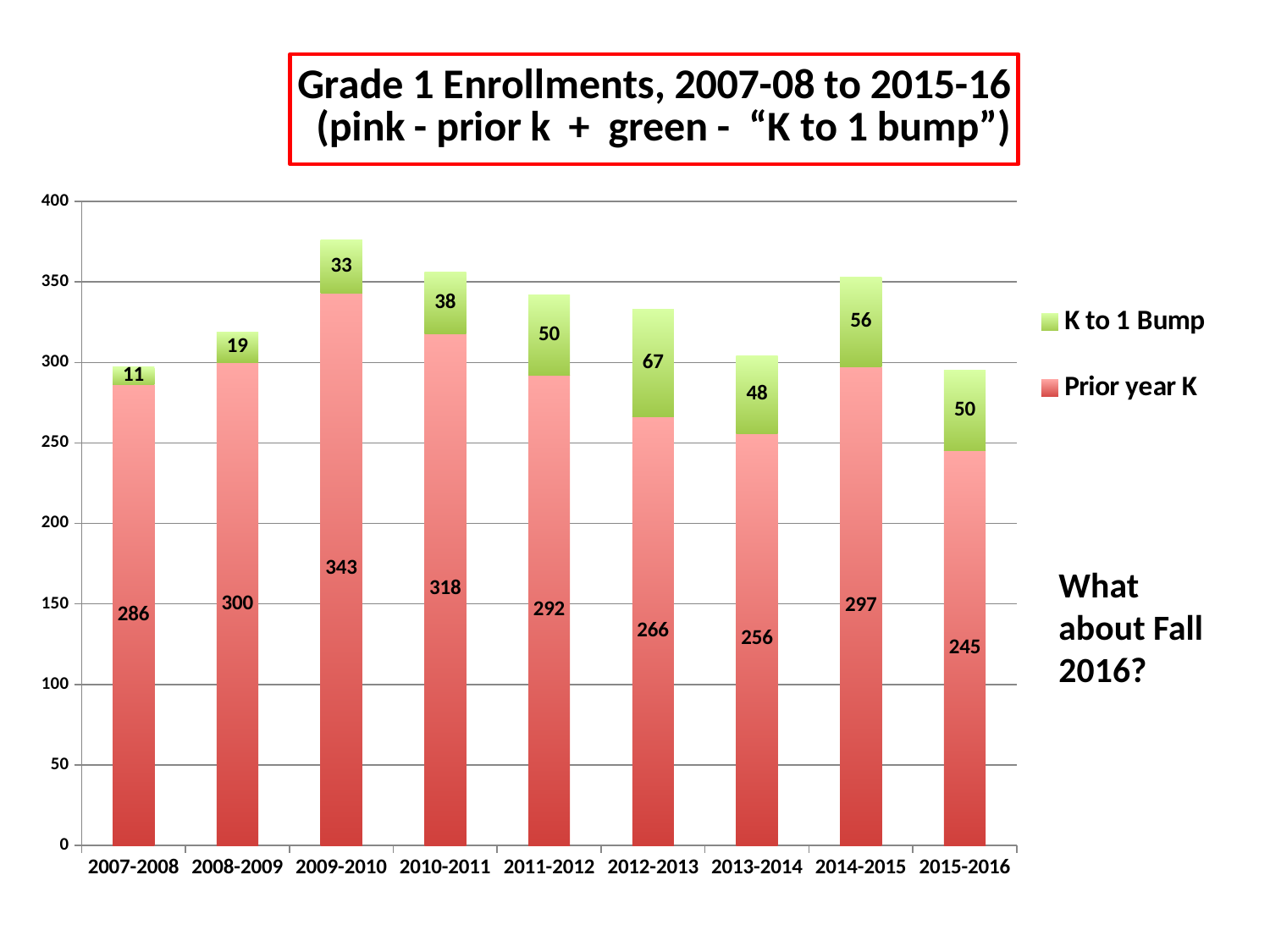
What is the difference between the Prior year K values for 2014-2015 and 2015-2016? 52 Which year has the highest Prior year K value? 2009-2010 Which is larger, the K to 1 Bump for 2011-2012 or for 2013-2014? 2011-2012 What is the Prior year K value for 2009-2010? 343 Which year has the lowest K to 1 Bump value? 2007-2008 What is the total Grade 1 enrollment (Prior year K plus K to 1 Bump) for 2015-2016? 295 How many series does the legend list? 2 How many school years are shown on the x axis? 9 What is the K to 1 Bump value for 2012-2013? 67 What is the total Grade 1 enrollment (Prior year K plus K to 1 Bump) for 2010-2011? 356 What kind of chart is shown on the slide? Stacked bar chart Which colour represents the K to 1 Bump series? Green